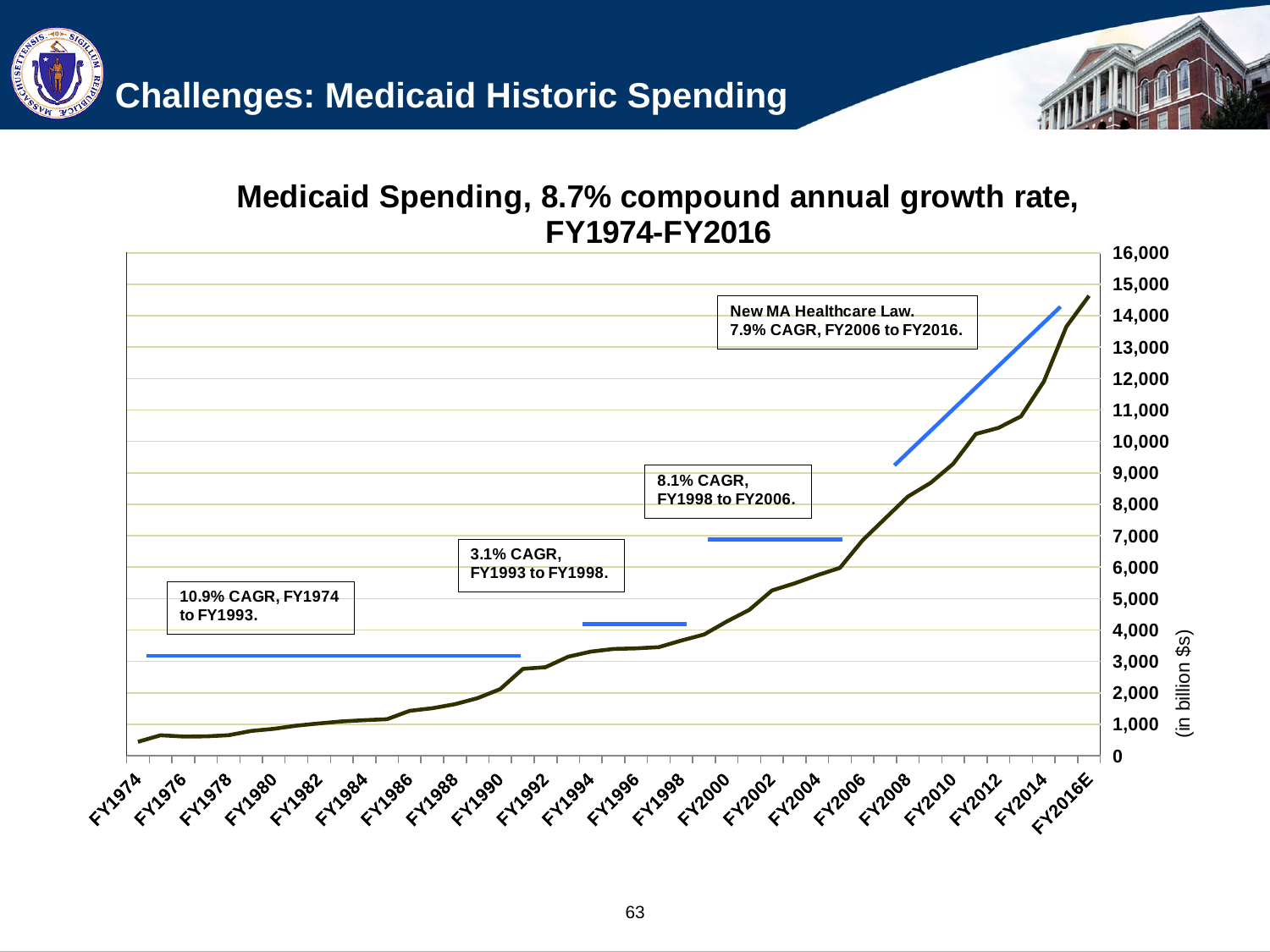
Which is larger, Medicaid spending in FY2006 or in FY2014? FY2014 What kind of chart is shown on the slide? line chart Is the value for FY2016E greater or less than 14,000? greater What compound annual growth rate does the chart title give for FY1974-FY2016? 8.7% Is the value for FY1998 greater or less than 4,000? less Is the value for FY1986 greater or less than 1,000? greater Which fiscal year has the lowest Medicaid spending on the chart? FY1974 Do Medicaid spending values generally rise or fall from FY1974 to FY2016E? rise What CAGR does the chart annotation give for FY1993 to FY1998? 3.1% Which fiscal year has the highest Medicaid spending on the chart? FY2016E